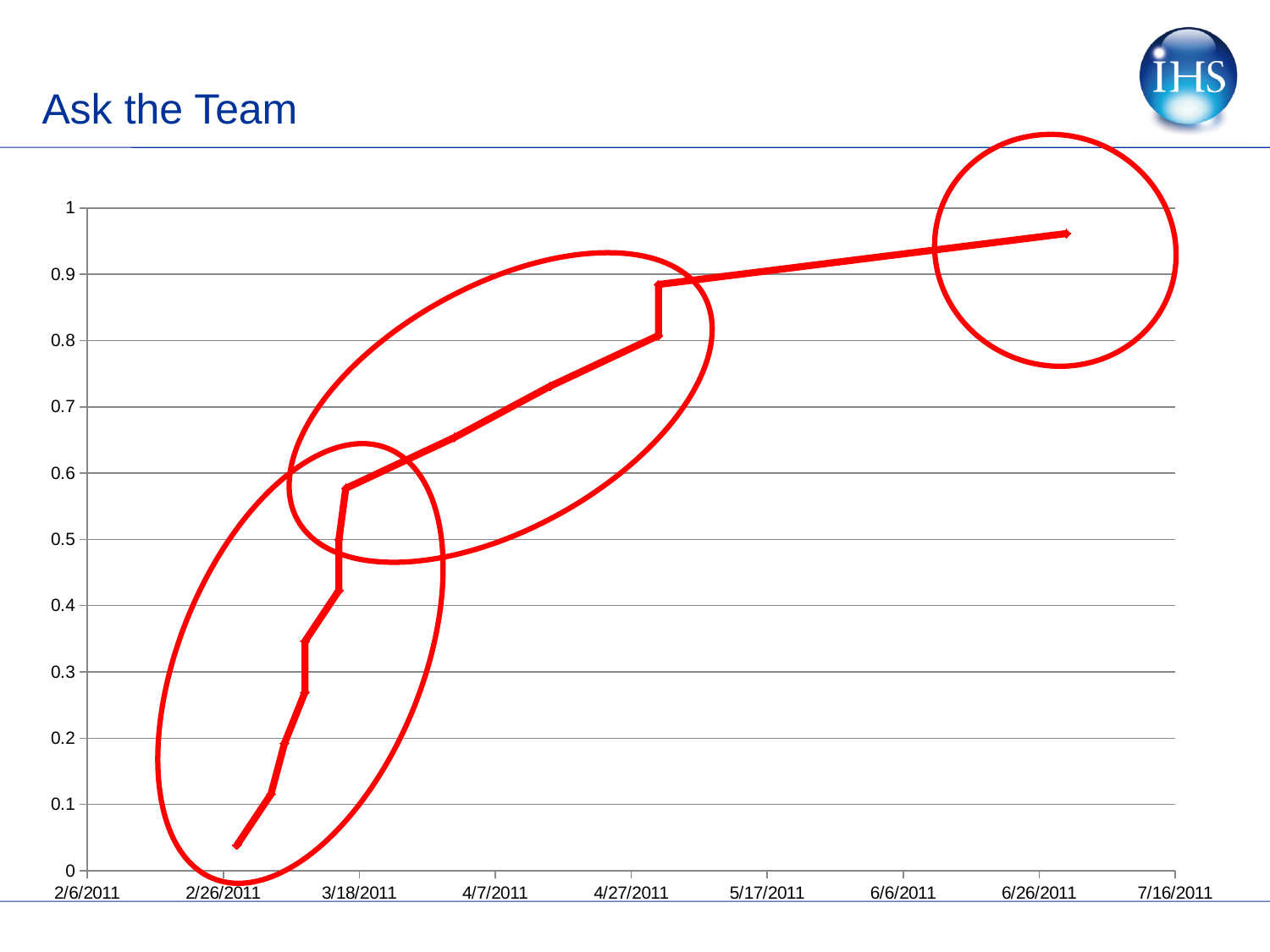
Which point on the line has the highest value, the leftmost or the rightmost? rightmost How many date labels are shown on the x axis? 9 Is the value of the first (leftmost) point on the line greater or less than 0.1? less Which point on the line has the lowest value, the leftmost or the rightmost? leftmost What kind of chart is shown on the slide? line chart What is the maximum value shown on the y axis? 1 Is the value of the point plotted just before 3/18/2011 at the top of the small circle greater or less than 0.5? greater Is the value of the last (rightmost) point on the line greater or less than 0.9? greater Do the plotted values generally rise or fall from left to right along the x axis? rise What is the first date label shown on the x axis? 2/6/2011